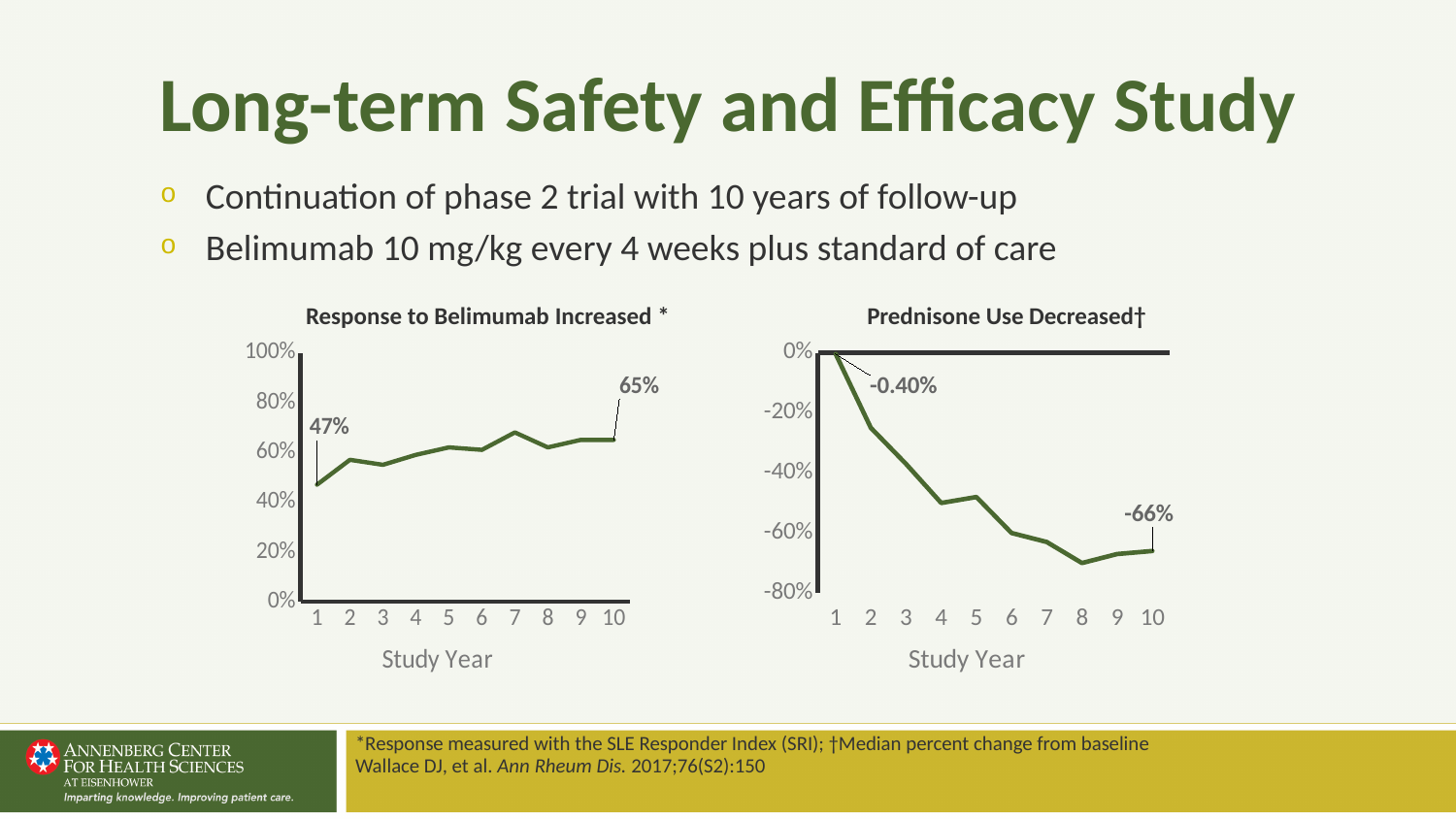
In the 'Response to Belimumab Increased' chart, what is the difference between the value at study year 10 and the value at study year 1? 18% In the 'Response to Belimumab Increased' chart, what is the value at study year 1? 47% What is the x-axis label on the 'Prednisone Use Decreased' chart? Study Year How many study years are plotted on the x axis of the 'Prednisone Use Decreased' chart? 10 What kind of chart is the 'Prednisone Use Decreased' chart? Line chart In the 'Prednisone Use Decreased' chart, do the values generally rise or fall across the study years? Fall In the 'Prednisone Use Decreased' chart, what is the value at study year 10? -66% In the 'Response to Belimumab Increased' chart, is the value at study year 5 greater or less than 40%? greater In the 'Response to Belimumab Increased' chart, do the values generally rise or fall across the study years? Rise In the 'Response to Belimumab Increased' chart, what is the value at study year 10? 65% In the 'Prednisone Use Decreased' chart, what is the value at study year 1? -0.40% What kind of chart is the 'Response to Belimumab Increased' chart? Line chart